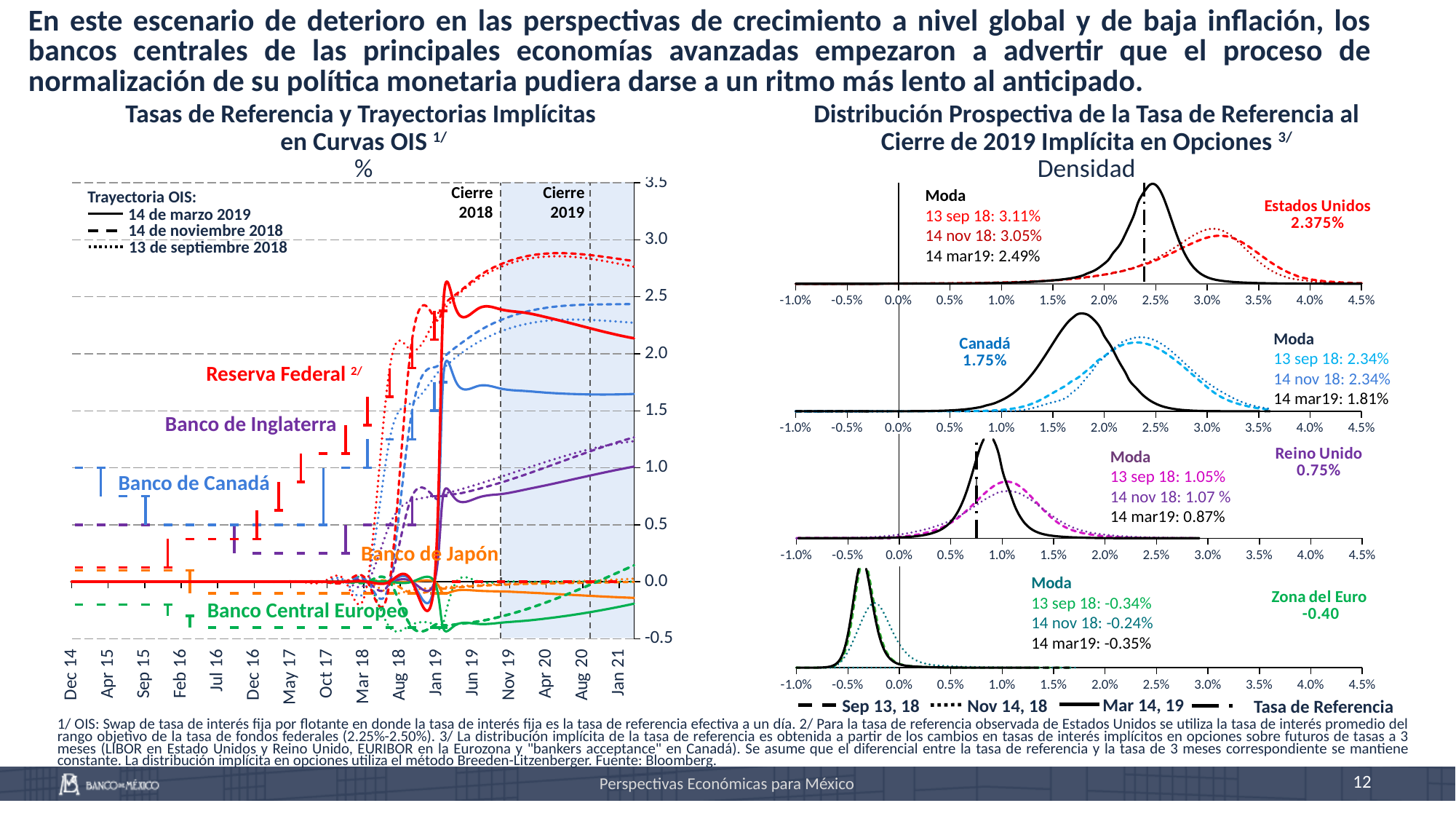
On the right chart, what is the mode for Canadá on 13 sep 18? 2.34% How many density panels (economies) does the right chart show? 4 On the right chart, what is the mode for Reino Unido on 14 nov 18? 1.07 % On the right chart, what is the difference between the Estados Unidos mode on 13 sep 18 and on 14 mar 19? 0.62% On the right chart, what is the mode for Zona del Euro on 14 mar 19? -0.35% On the right chart, is the Canadá mode on 14 mar 19 larger or smaller than the Reino Unido mode on 14 mar 19? larger On the left chart (Tasas de Referencia y Trayectorias Implícitas en Curvas OIS), is the Reserva Federal solid line at Jan 21 greater or less than 2.0? greater On the left chart, is the Banco Central Europeo solid line at Jan 21 greater or less than 0.0? less On the right chart, what reference rate is shown for Estados Unidos? 2.375% What type of chart is the left chart (Tasas de Referencia y Trayectorias Implícitas en Curvas OIS)? line chart On the right chart (Distribución Prospectiva de la Tasa de Referencia), what is the mode for Estados Unidos on 14 mar 19? 2.49% On the right chart, which economy has the lowest reference rate shown? Zona del Euro